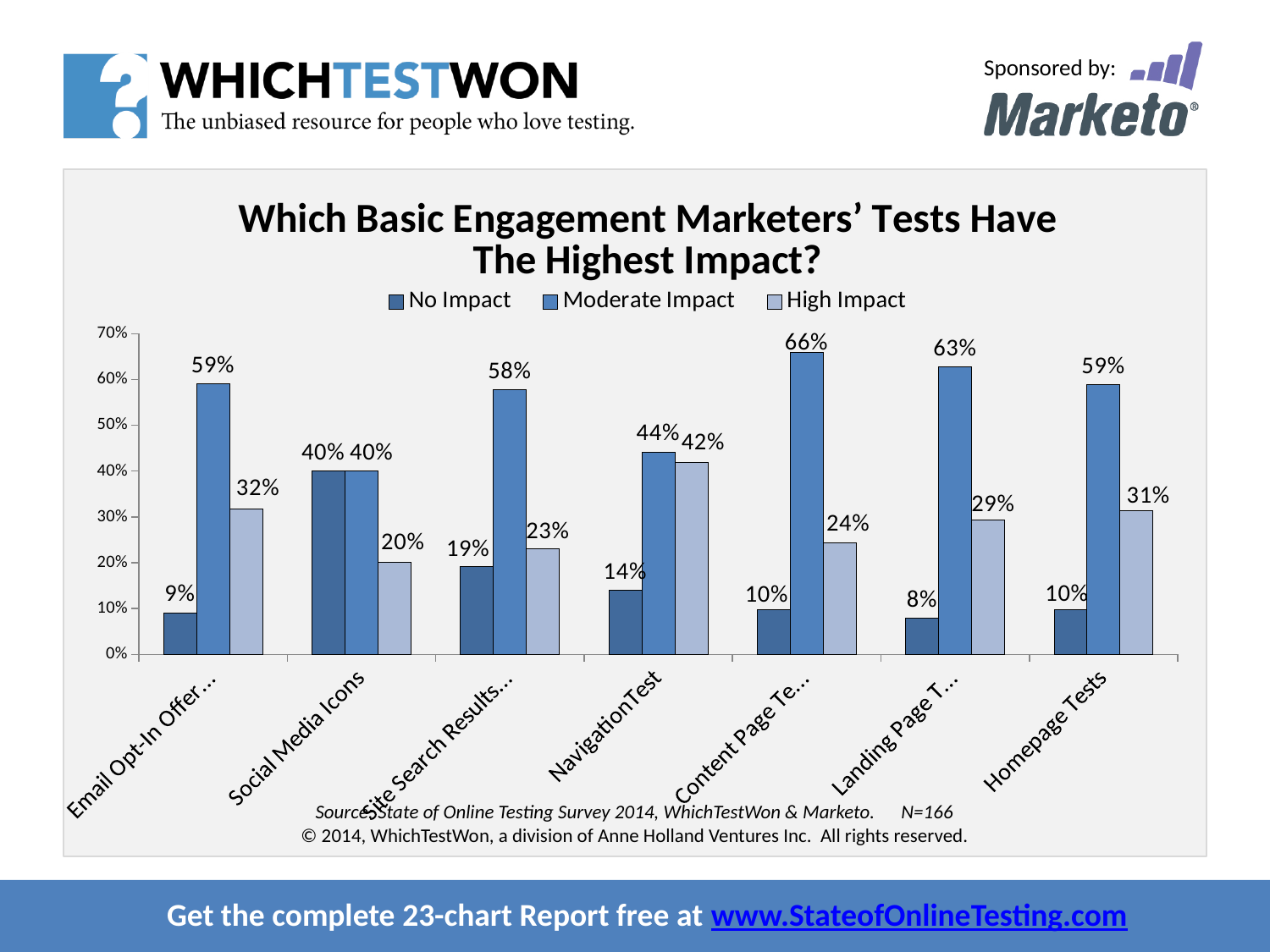
What is the High Impact value for Navigation Test? 42% How many series does the legend list? 3 What kind of chart is shown on the slide? Bar chart What is the title of the chart? Which Basic Engagement Marketers' Tests Have The Highest Impact? What is the lowest No Impact value shown on the chart? 8% How many test categories are shown on the x axis? 7 For Social Media Icons, what is the difference between the No Impact and High Impact values? 20% What is the No Impact value for Social Media Icons? 40% What is the highest Moderate Impact value shown on the chart? 66% What is the Moderate Impact value for Homepage Tests? 59% For Navigation Test, which is larger: the Moderate Impact value or the High Impact value? Moderate Impact For Homepage Tests, what is the difference between the Moderate Impact and High Impact values? 28%